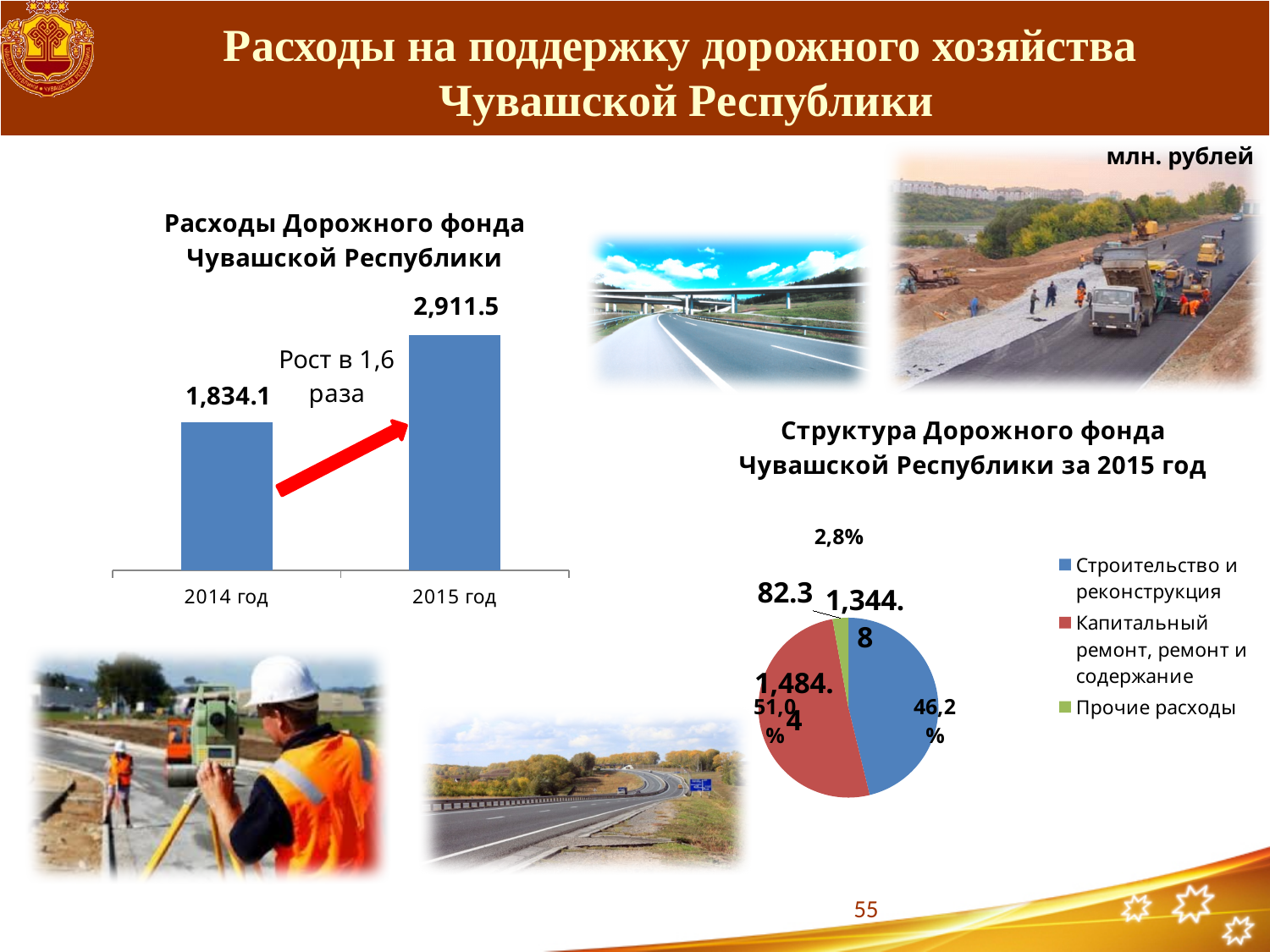
In the chart 'Расходы Дорожного фонда Чувашской Республики', which year has the higher value? 2015 год How many entries does the legend of the chart 'Структура Дорожного фонда Чувашской Республики за 2015 год' list? 3 In the chart 'Структура Дорожного фонда Чувашской Республики за 2015 год', which category has the largest slice? Капитальный ремонт, ремонт и содержание In the chart 'Структура Дорожного фонда Чувашской Республики за 2015 год', which colour represents 'Строительство и реконструкция'? blue In the chart 'Расходы Дорожного фонда Чувашской Республики', what is the value for 2015 год? 2,911.5 What kind of chart is 'Структура Дорожного фонда Чувашской Республики за 2015 год'? pie chart In the chart 'Расходы Дорожного фонда Чувашской Республики', what is the difference between the 2015 год and 2014 год values? 1,077.4 What kind of chart is 'Расходы Дорожного фонда Чувашской Республики'? bar chart In the chart 'Структура Дорожного фонда Чувашской Республики за 2015 год', what share of the pie is 'Прочие расходы'? 2,8% In the chart 'Расходы Дорожного фонда Чувашской Республики', what is the value for 2014 год? 1,834.1 In the chart 'Расходы Дорожного фонда Чувашской Республики', do the values rise or fall from 2014 год to 2015 год? rise How many bars are in the chart 'Расходы Дорожного фонда Чувашской Республики'? 2